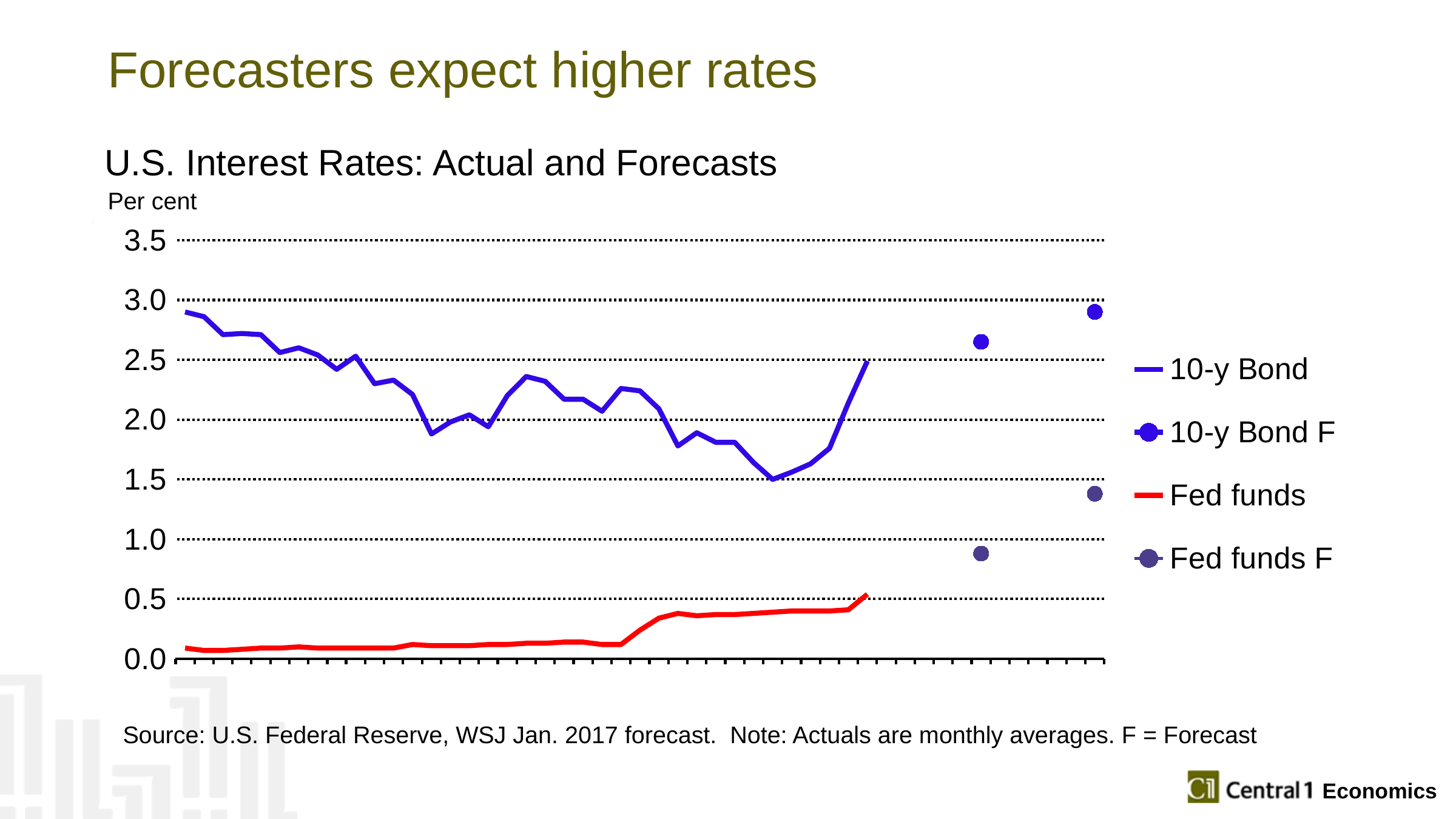
Is the lowest point of the 10-y Bond line greater or less than 2.0? less Is the starting value of the 10-y Bond line greater or less than 2.5? greater What kind of chart is shown on the slide? line chart What unit is shown on the vertical axis of the chart? Per cent Is the higher of the two Fed funds F forecast points greater or less than 1.0? greater How many series does the legend list? 4 Which series is higher throughout the chart, 10-y Bond or Fed funds? 10-y Bond Does the Fed funds line generally rise or fall along the x axis? rise What is the title of the chart? U.S. Interest Rates: Actual and Forecasts Which of the two Fed funds F forecast points is higher, the first or the second? the second